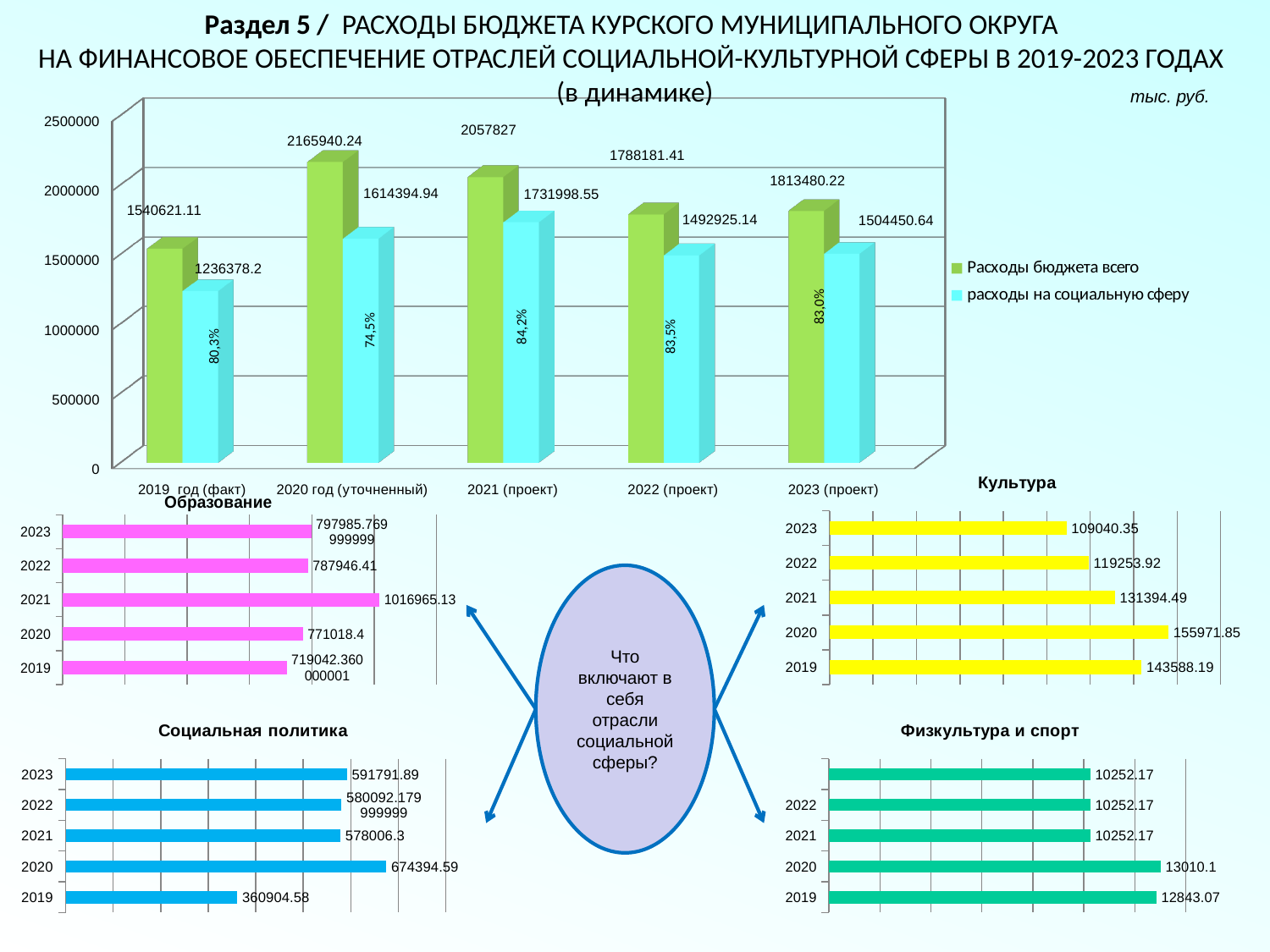
In the top chart, what is the difference between 'Расходы бюджета всего' and 'расходы на социальную сферу' for 2020 год (уточненный)? 551545.3 In the top chart, what is the value of 'Расходы бюджета всего' for 2020 год (уточненный)? 2165940.24 How many year categories are shown on the x axis of the top chart? 5 In the 'Культура' chart, which year has the highest value? 2020 In the 'Социальная политика' chart, what is the value for 2020? 674394.59 In the 'Физкультура и спорт' chart, what is the value for 2020? 13010.1 In the 'Образование' chart, which year has the highest value? 2021 How many series does the legend of the top chart list? 2 In the 'Социальная политика' chart, which year has the lowest value? 2019 In the top chart, which year has the highest value of 'Расходы бюджета всего'? 2020 год (уточненный) In the top chart, what is the value of 'расходы на социальную сферу' for 2021 (проект)? 1731998.55 In the 'Культура' chart, what is the value for 2023? 109040.35